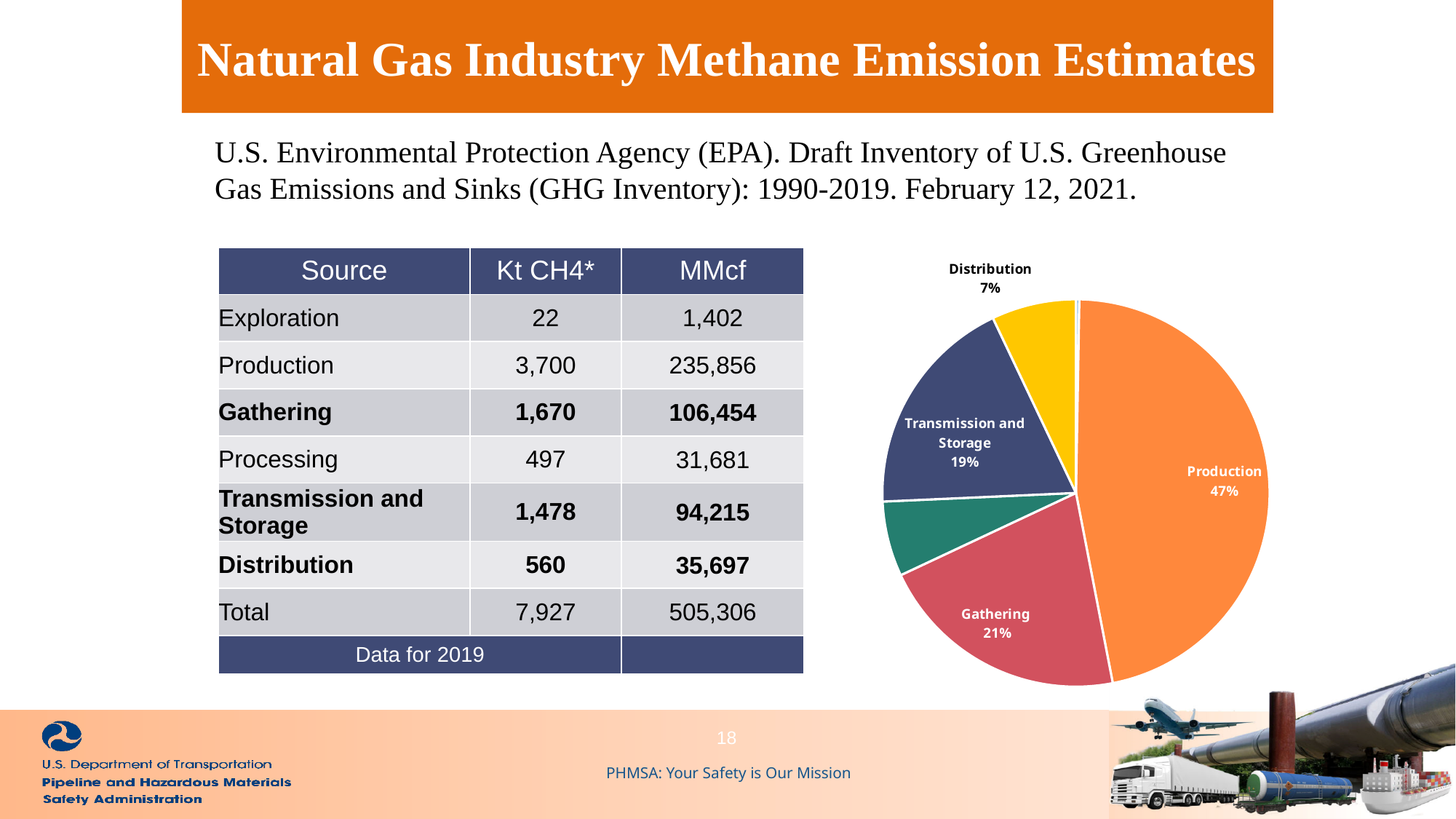
In the pie chart, how many percentage points larger is Gathering's share than Distribution's share? 14 In the pie chart, what share is labeled for Production? 47% What kind of chart is shown on the right side of the slide? pie chart In the pie chart, how many percentage points larger is Production's share than Gathering's share? 26 What colour is the Production slice in the pie chart? orange In the pie chart, which is larger: the Gathering slice or the Transmission and Storage slice? Gathering What colour is the Distribution slice in the pie chart? yellow Among the labeled slices of the pie chart, which has the smallest share? Distribution In the pie chart, what share is labeled for Distribution? 7% In the pie chart, what share is labeled for Gathering? 21% Which slice of the pie chart is the largest? Production In the pie chart, what share is labeled for Transmission and Storage? 19%